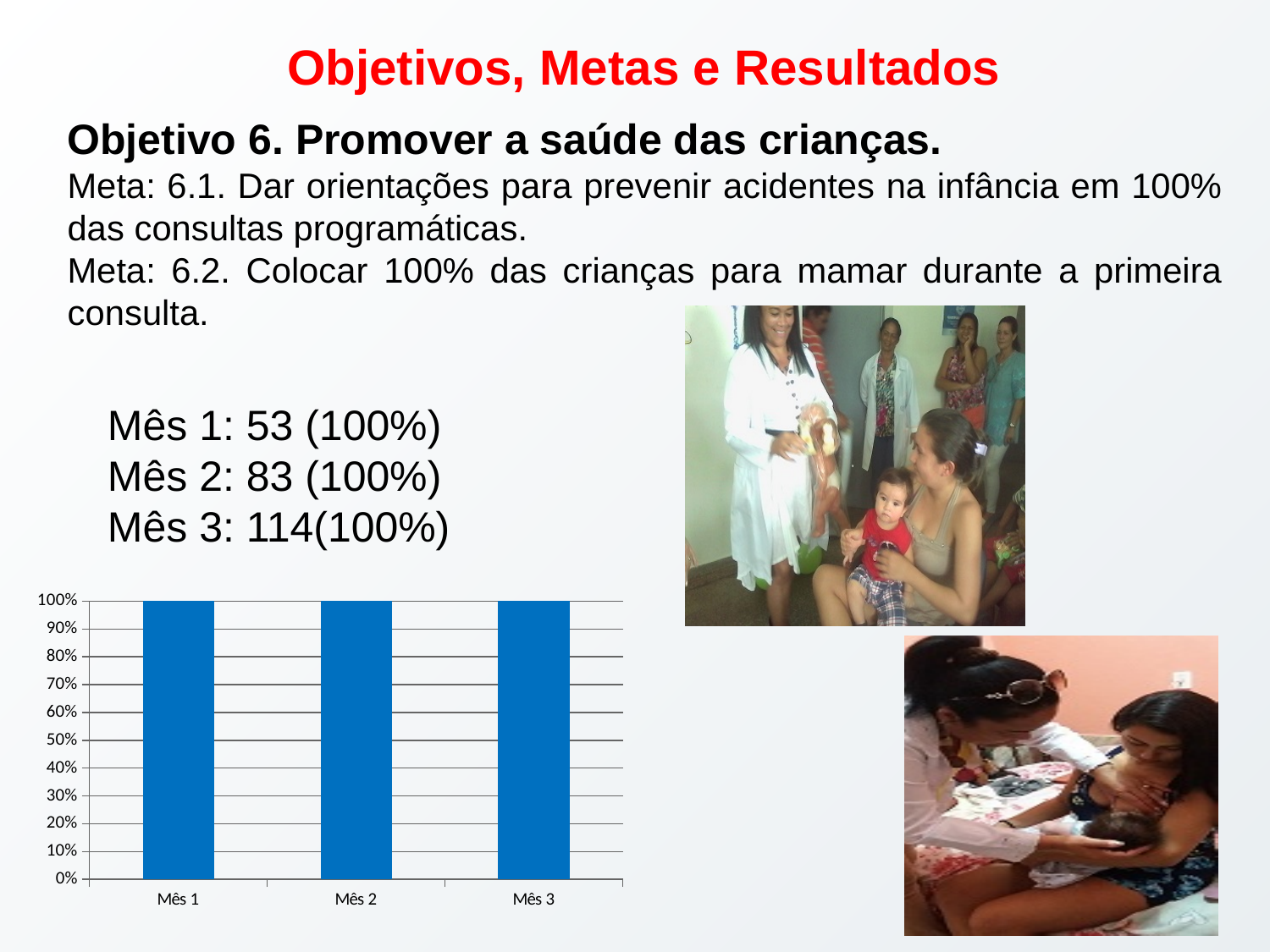
What is the difference between the values for Mês 3 and Mês 1? 0% What is the value for Mês 3 in the chart? 100% What is the value for Mês 2 in the chart? 100% What kind of chart is shown on the slide? bar chart What is the highest tick shown on the y axis of the chart? 100% What is the value for Mês 1 in the chart? 100% Is the value for Mês 2 greater or less than 50%? greater Is the value for Mês 3 greater or less than 90%? greater How many categories are shown on the x axis of the chart? 3 What is the label of the first category on the x axis? Mês 1 Do the values rise, fall or stay the same from Mês 1 to Mês 3? stay the same